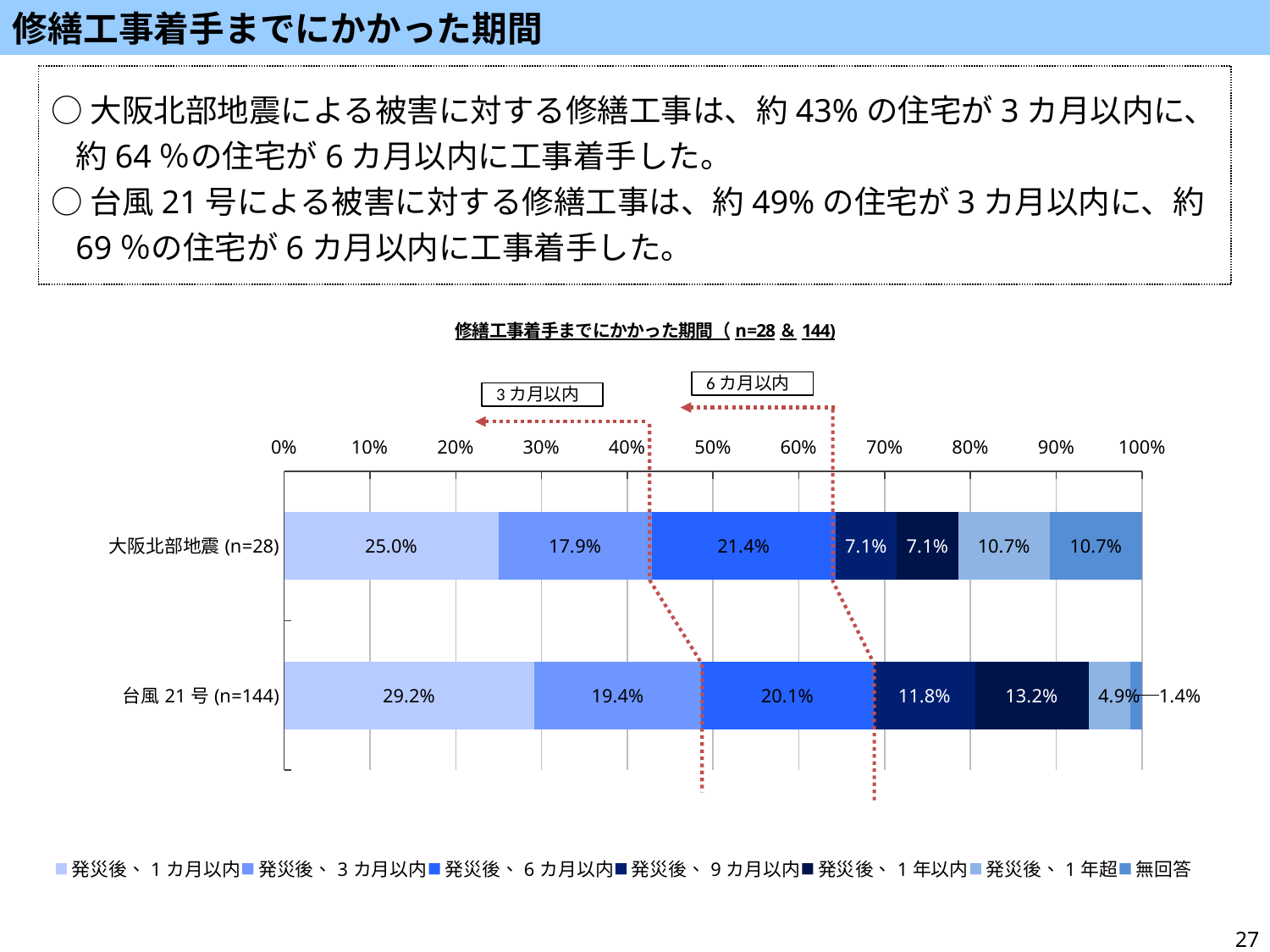
What type of chart is shown on the slide? Stacked bar chart Which segment is the largest in the 台風21号 (n=144) bar? 発災後、1カ月以内 What is the title of the chart? 修繕工事着手までにかかった期間（n=28 & 144） What is the difference between the 発災後、1年超 values for 大阪北部地震 (n=28) and 台風21号 (n=144)? 5.8% How many series does the legend list? 7 What is the value of 発災後、1年以内 for 台風21号 (n=144)? 13.2% What is the value of 発災後、1カ月以内 for 大阪北部地震 (n=28)? 25.0% Which category has the larger value for 発災後、3カ月以内: 大阪北部地震 (n=28) or 台風21号 (n=144)? 台風21号 (n=144) What is the value of 発災後、6カ月以内 for 大阪北部地震 (n=28)? 21.4% What is the value of 発災後、1カ月以内 for 台風21号 (n=144)? 29.2% What is the value of 無回答 for 台風21号 (n=144)? 1.4% How many categories (bars) are plotted in the chart? 2